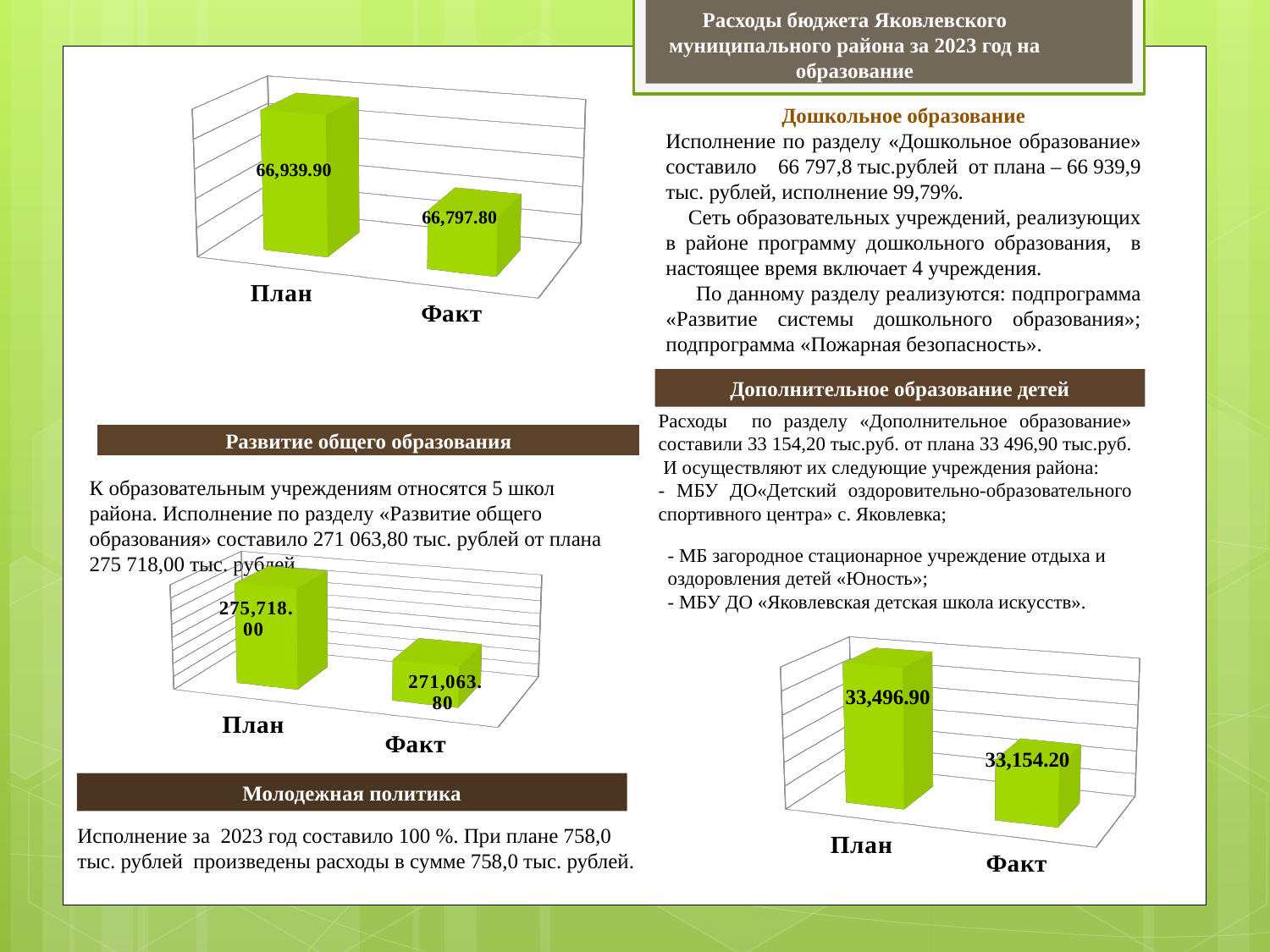
In the middle-left chart, what is the difference between План and Факт? 4,654.20 In the top-left chart, what is the value for Факт? 66,797.80 In the bottom-right chart, what is the value for Факт? 33,154.20 In the top-left chart, what is the value for План? 66,939.90 In the bottom-right chart, what is the difference between План and Факт? 342.70 In the middle-left chart, what is the value for Факт? 271,063.80 In the bottom-right chart, which category has the lowest value? Факт In the middle-left chart, which category has the higher value, План or Факт? План In the top-left chart, what is the difference between План and Факт? 142.10 What type of chart is the top-left chart? Bar chart In the middle-left chart, what is the value for План? 275,718.00 In the bottom-right chart, what is the value for План? 33,496.90